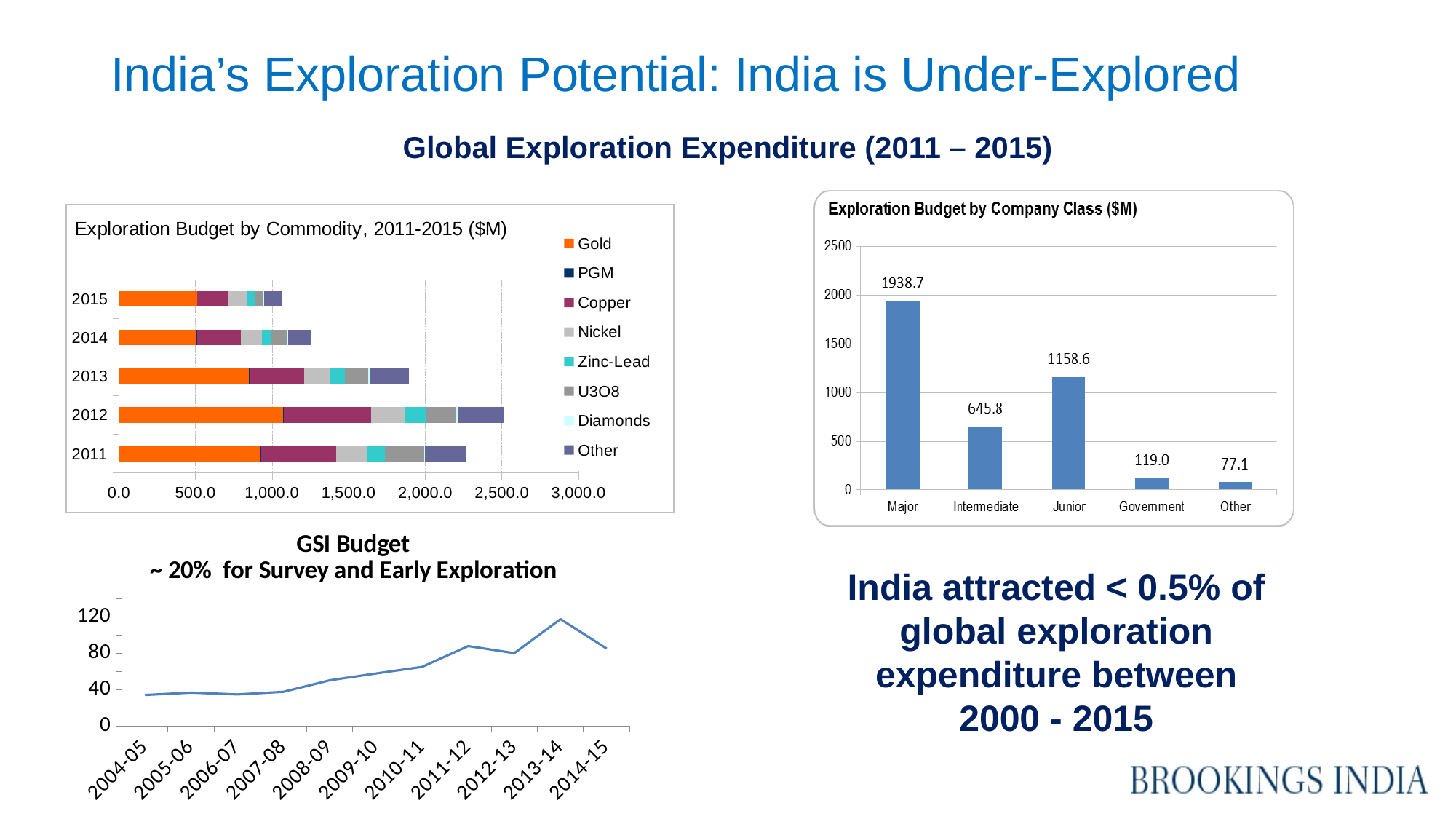
In the Exploration Budget by Commodity chart, is the total for 2015 greater or less than 1,500.0? less In the Exploration Budget by Company Class chart, which company class has the lowest value? Other How many series does the legend of the Exploration Budget by Commodity chart list? 8 In the GSI Budget chart, which year has the highest value? 2013-14 What kind of chart is the Exploration Budget by Commodity chart? Stacked bar chart How many data points are plotted in the GSI Budget line chart? 11 In the Exploration Budget by Company Class chart, what is the value for Government? 119.0 In the Exploration Budget by Company Class chart, what is the value for Major? 1938.7 How many company classes are shown in the Exploration Budget by Company Class chart? 5 In the Exploration Budget by Company Class chart, which is larger, Intermediate or Junior? Junior In the Exploration Budget by Commodity chart, which year has the larger total bar, 2012 or 2015? 2012 In the Exploration Budget by Company Class chart, what is the difference between Major and Junior? 780.1